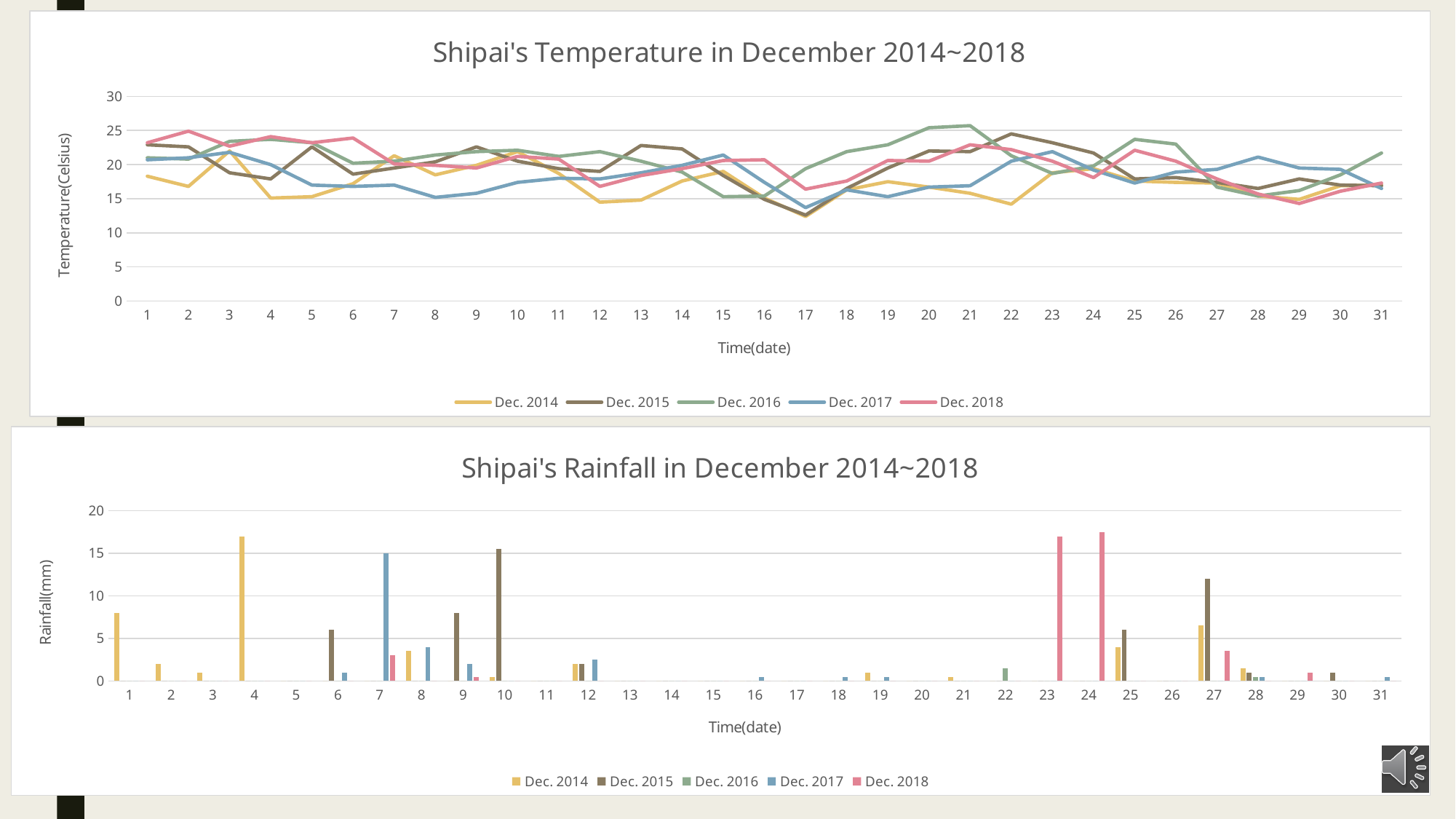
In "Shipai's Rainfall in December 2014~2018", which is larger for Dec. 2014: the bar on date 1 or the bar on date 4? date 4 How many dates are shown on the x axis of "Shipai's Rainfall in December 2014~2018"? 31 In "Shipai's Rainfall in December 2014~2018", which series has the highest bar on date 27? Dec. 2015 In "Shipai's Rainfall in December 2014~2018", is the Dec. 2014 value on date 4 greater or less than 15? greater In "Shipai's Rainfall in December 2014~2018", is the Dec. 2018 value on date 24 greater or less than 15? greater In "Shipai's Temperature in December 2014~2018", is the Dec. 2015 value on date 17 greater or less than 15? less What kind of chart is "Shipai's Rainfall in December 2014~2018"? bar chart How many series does the legend of "Shipai's Temperature in December 2014~2018" list? 5 What is the y-axis label of "Shipai's Rainfall in December 2014~2018"? Rainfall(mm) What kind of chart is "Shipai's Temperature in December 2014~2018"? line chart